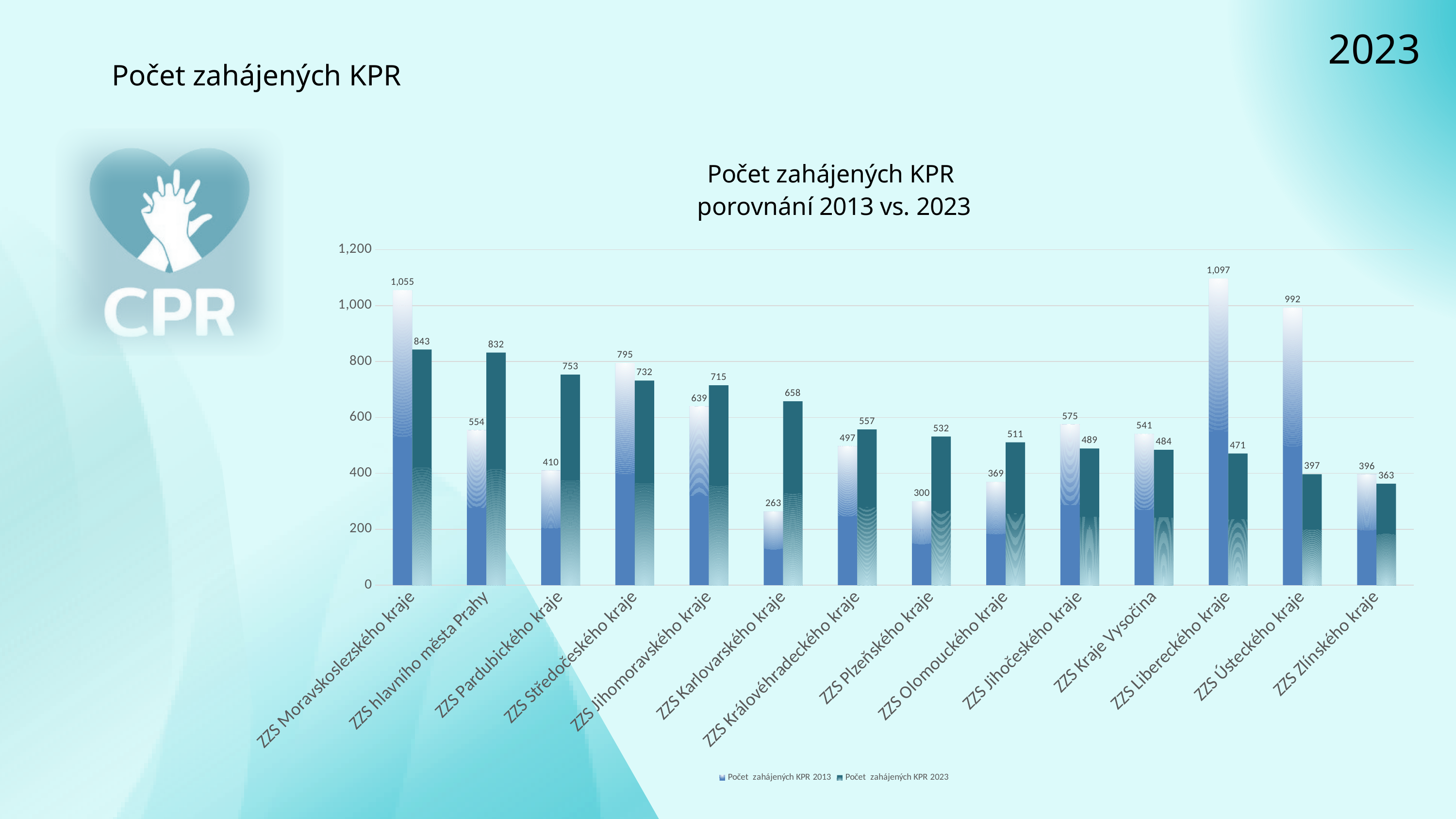
What is the difference between the 2013 and 2023 values for ZZS Pardubického kraje? 343 For ZZS hlavního města Prahy, which is larger: the 2013 value or the 2023 value? 2023 value What is the value for ZZS Ústeckého kraje in the 'Počet zahájených KPR 2023' series? 397 Does the 'Počet zahájených KPR 2023' series rise or fall from ZZS Moravskoslezského kraje to ZZS Zlínského kraje? Fall Which category has the highest value in the 'Počet zahájených KPR 2023' series? ZZS Moravskoslezského kraje How many categories (regions) are shown on the x axis? 14 What is the value for ZZS Libereckého kraje in the 'Počet zahájených KPR 2013' series? 1,097 How many series does the legend list? 2 What is the value for ZZS Karlovarského kraje in the 'Počet zahájených KPR 2023' series? 658 What kind of chart is shown on the slide? Bar chart Which category has the lowest value in the 'Počet zahájených KPR 2013' series? ZZS Karlovarského kraje What is the title of the chart? Počet zahájených KPR porovnání 2013 vs. 2023